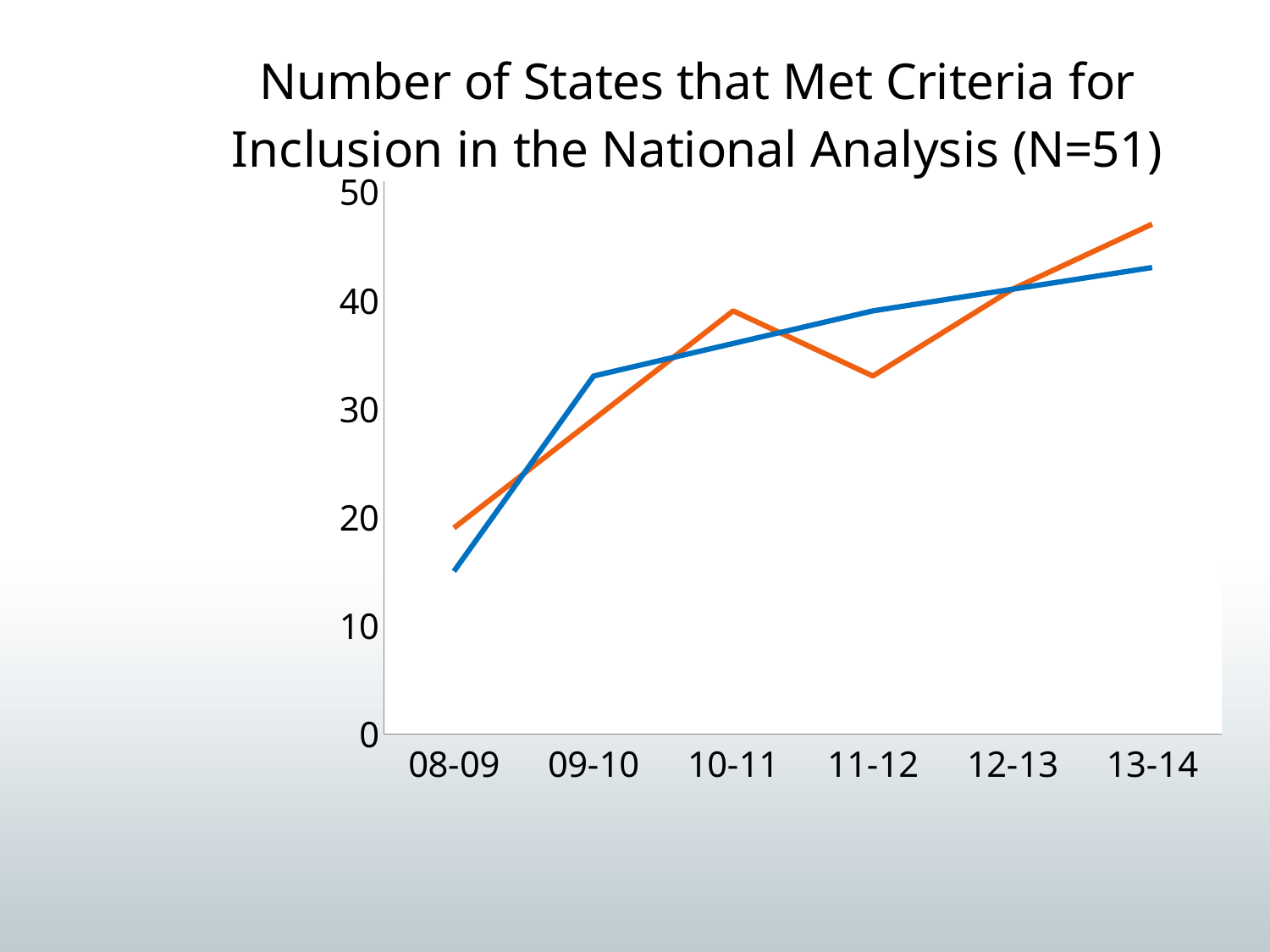
In which school year does the orange line reach its highest value? 13-14 Is the value of the orange line for 11-12 greater or less than 40? less What kind of chart is shown on the slide? line chart Is the value of the orange line for 13-14 greater or less than 40? greater What is the title of the chart? Number of States that Met Criteria for Inclusion in the National Analysis (N=51) Is the value of the blue line for 08-09 greater or less than 20? less In which school year does the blue line have its lowest value? 08-09 At 11-12, which line has the higher value, the blue line or the orange line? the blue line Does the blue line rise or fall from 08-09 to 13-14? rise At 08-09, which line has the higher value, the blue line or the orange line? the orange line How many school years are shown on the x axis? 6